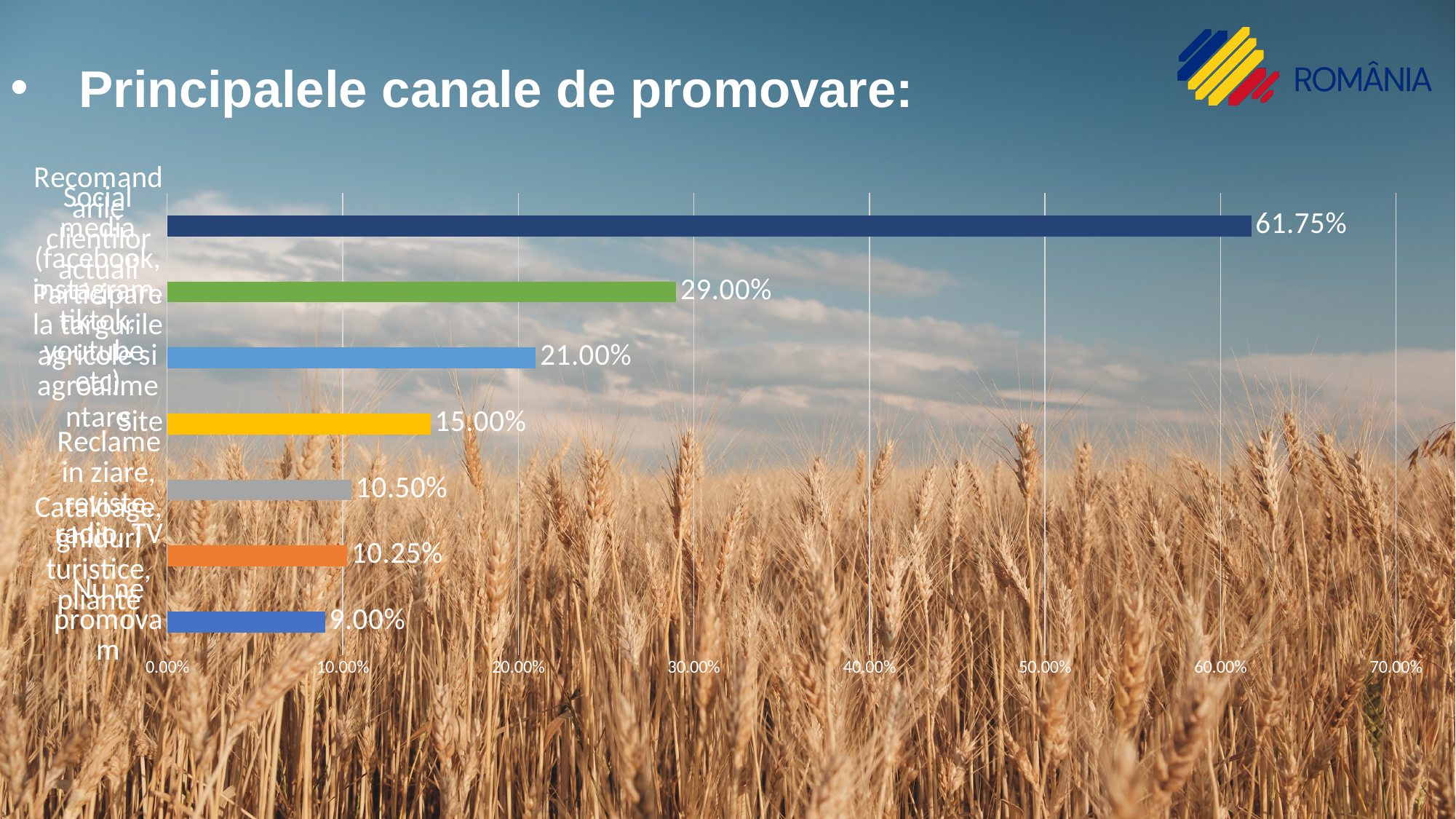
What is the highest value shown in the chart? 61.75% What value is shown for the green bar (second from the top)? 29.00% What kind of chart is shown on the slide? bar chart Which is larger, the value of the grey bar or the value of the orange bar? the grey bar (10.50%) What is the lowest value shown in the chart? 9.00% What is the difference between the top bar (61.75%) and the second bar (29.00%)? 32.75% What value is shown for the yellow bar labelled "Site"? 15.00% What is the title of the slide above the chart? Principalele canale de promovare: How many bars does the chart contain? 7 What value is shown for the bottom bar, "Nu ne promovam"? 9.00% Is the value of the top (dark blue) bar greater or less than 60.00%? greater What is the difference between the grey bar (10.50%) and the orange bar (10.25%)? 0.25%